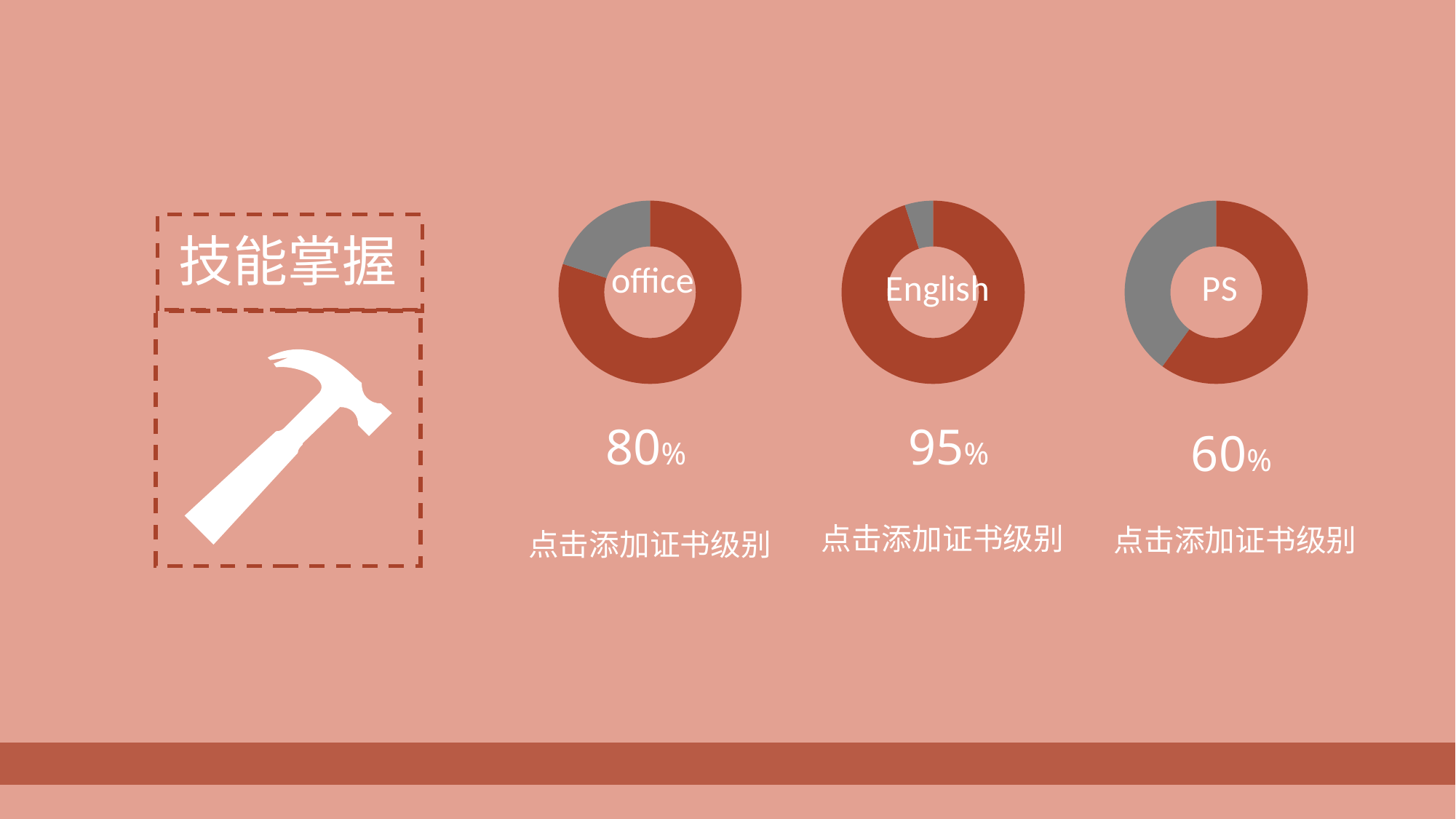
How many donut charts are shown on the slide? 3 What is the difference between the English percentage and the PS percentage? 35% What percentage is shown for the office donut chart? 80% What percentage is shown for the English donut chart? 95% What is the difference between the office percentage and the PS percentage? 20% Which is larger, the office percentage or the English percentage? English What kind of chart is used to show each skill level? Donut chart What label is shown in the centre of the middle donut chart? English Which of the three skills (office, English, PS) has the lowest percentage? PS What percentage is shown for the PS donut chart? 60% Which of the three skills (office, English, PS) has the highest percentage? English What is the title of the slide section containing the charts? 技能掌握